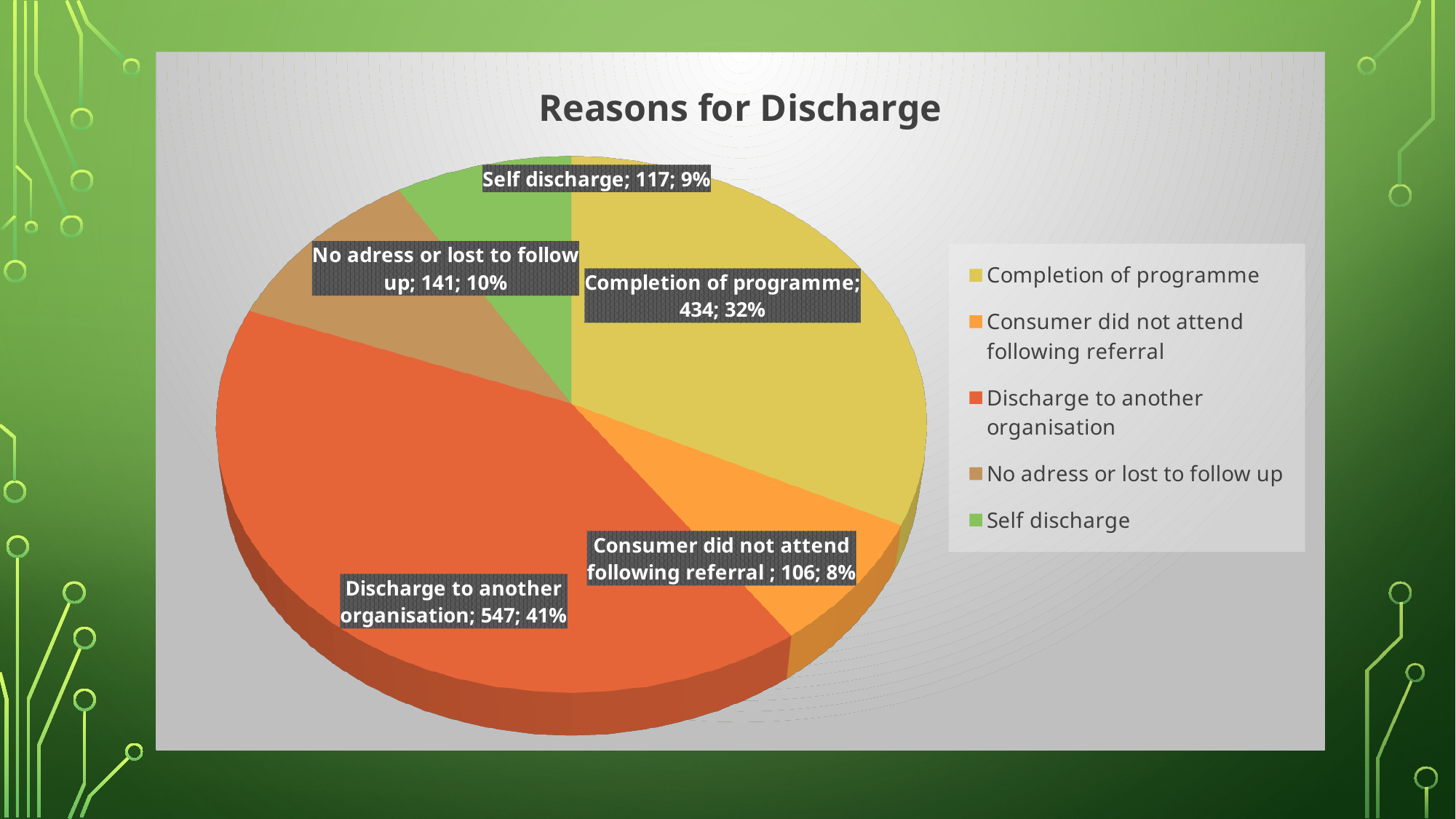
What is the value for No adress or lost to follow up? 141 How many categories are shown in the pie chart? 5 What share of the pie does Completion of programme represent? 32% What is the difference between Discharge to another organisation and Completion of programme? 113 What share of the pie does Consumer did not attend following referral represent? 8% Which category has the lowest value? Consumer did not attend following referral Which is larger, No adress or lost to follow up or Self discharge? No adress or lost to follow up What is the value for Completion of programme? 434 Which category has the highest value? Discharge to another organisation What is the value for Self discharge? 117 What kind of chart is shown on the slide? Pie chart What is the value for Discharge to another organisation? 547